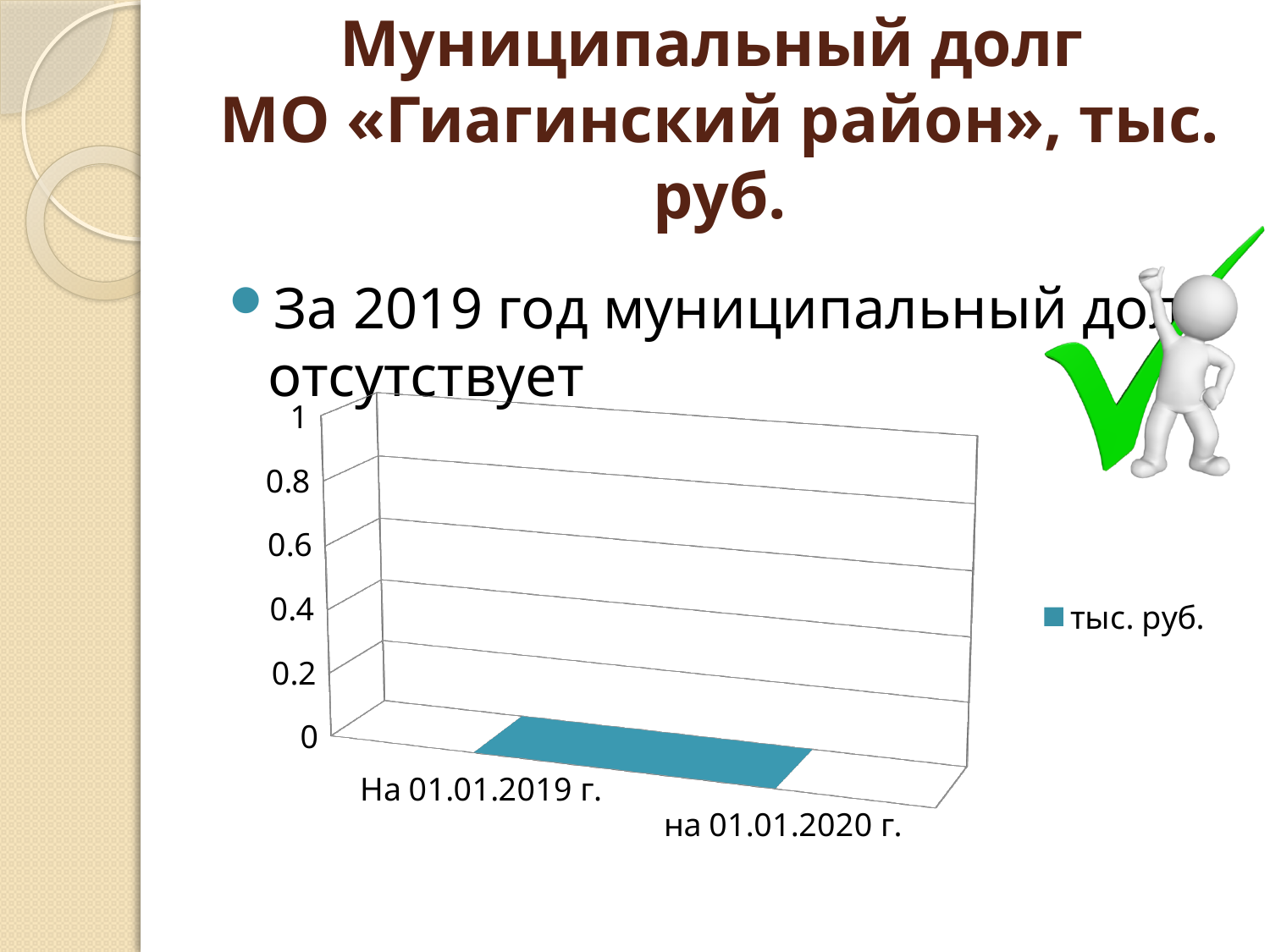
What is the value for На 01.01.2019 г. in the chart? 0 What is the difference between the values for На 01.01.2019 г. and на 01.01.2020 г.? 0 How many categories are shown on the x axis of the chart? 2 Do the values rise, fall or stay the same from На 01.01.2019 г. to на 01.01.2020 г.? stay the same What is the value for на 01.01.2020 г. in the chart? 0 How many series does the chart legend list? 1 What is the legend entry of the chart? тыс. руб. What kind of chart is shown on the slide? line chart Is the value for На 01.01.2019 г. greater or less than 0.2? less Is the value for на 01.01.2020 г. greater or less than 0.4? less What is the highest value shown on the vertical axis of the chart? 1